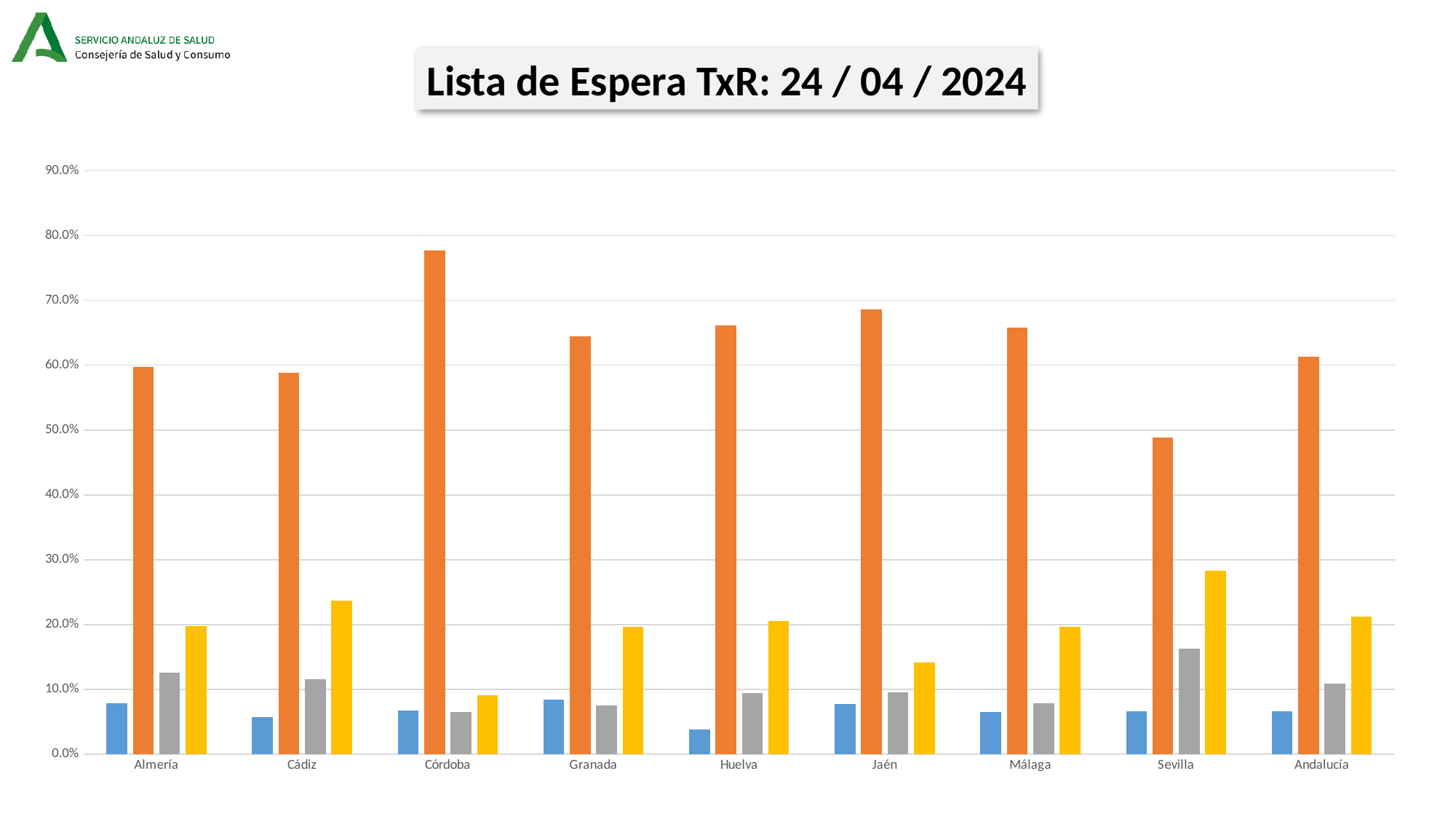
Is the orange bar for Córdoba greater or less than 70.0%? greater Which category has the highest orange bar? Córdoba Which category has the lowest blue bar? Huelva How many categories are shown along the x axis? 9 Which category has the lowest yellow bar? Córdoba What kind of chart is shown on the slide? bar chart Is the orange bar for Sevilla greater or less than 50.0%? less Which category has the highest yellow bar? Sevilla Which is larger, the orange bar for Jaén or the orange bar for Granada? Jaén Which category has the lowest orange bar? Sevilla How many bars (series) are plotted for each category? 4 What is the title of the slide's chart? Lista de Espera TxR: 24 / 04 / 2024